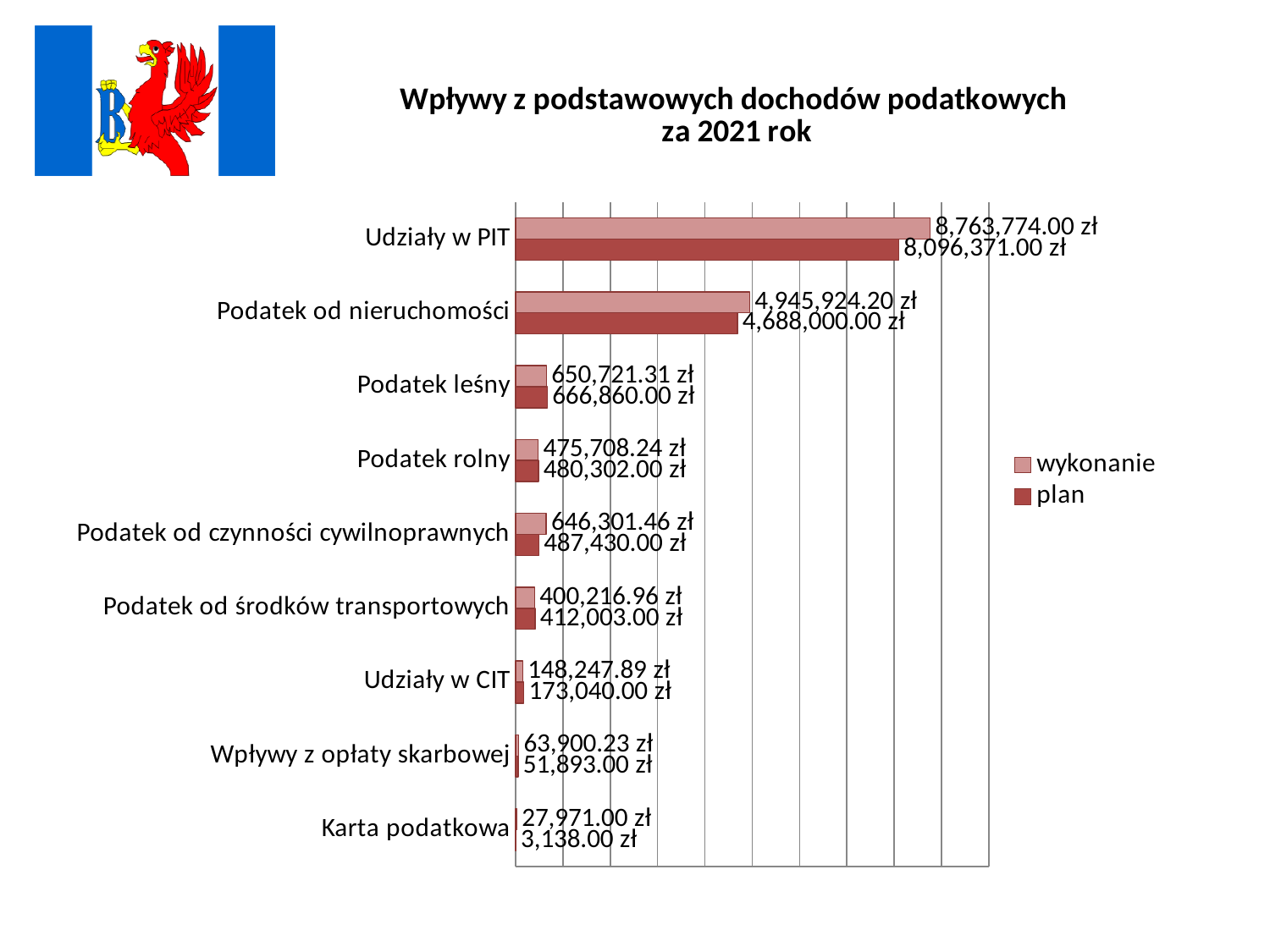
What is the wykonanie value for Udziały w PIT? 8,763,774.00 zł Which category has the lowest plan value? Karta podatkowa How many categories are shown on the chart? 9 What is the plan value for Podatek od nieruchomości? 4,688,000.00 zł What kind of chart is shown on the slide? bar chart How many series does the legend list? 2 What is the plan value for Karta podatkowa? 3,138.00 zł What is the difference between the wykonanie and plan values for Udziały w PIT? 667,403.00 zł What is the difference between the wykonanie and plan values for Podatek od nieruchomości? 257,924.20 zł What is the wykonanie value for Podatek od środków transportowych? 400,216.96 zł Which category has the highest wykonanie value? Udziały w PIT For Podatek od czynności cywilnoprawnych, which is larger: wykonanie or plan? wykonanie